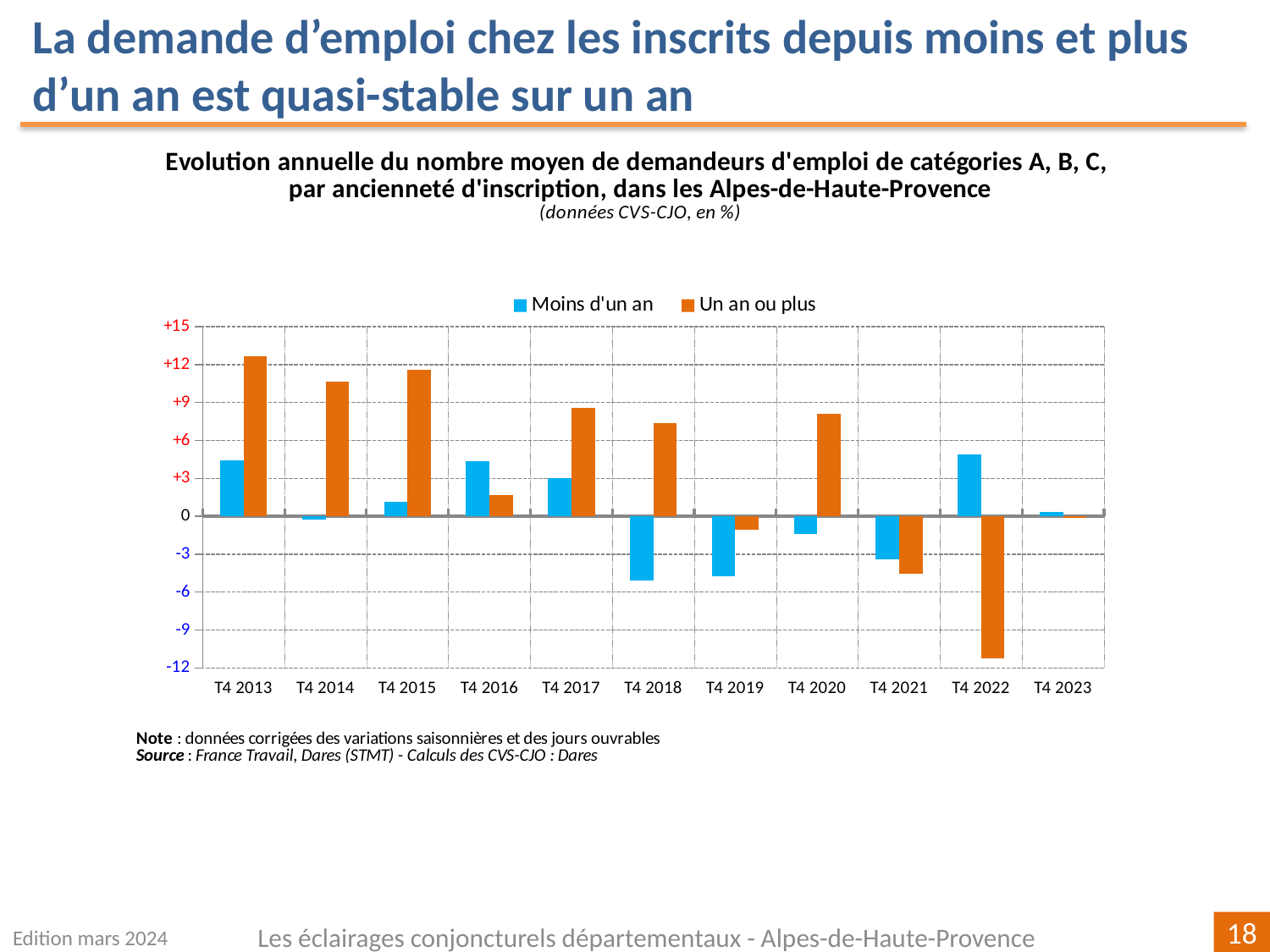
Is the value for 'Un an ou plus' in T4 2020 greater or less than 6? greater What kind of chart is shown on the slide? bar chart Which quarter has the lowest value for the 'Un an ou plus' series? T4 2022 How many series does the legend list? 2 What colour represents the 'Un an ou plus' series? orange Is the value for 'Moins d'un an' in T4 2018 greater or less than -3? less Is the value for 'Un an ou plus' in T4 2022 greater or less than -9? less How many quarters (categories) are shown on the x axis? 11 In T4 2016, which series has the larger value, 'Moins d'un an' or 'Un an ou plus'? Moins d'un an In T4 2017, which series has the larger value, 'Moins d'un an' or 'Un an ou plus'? Un an ou plus Which quarter has the highest value for the 'Un an ou plus' series? T4 2013